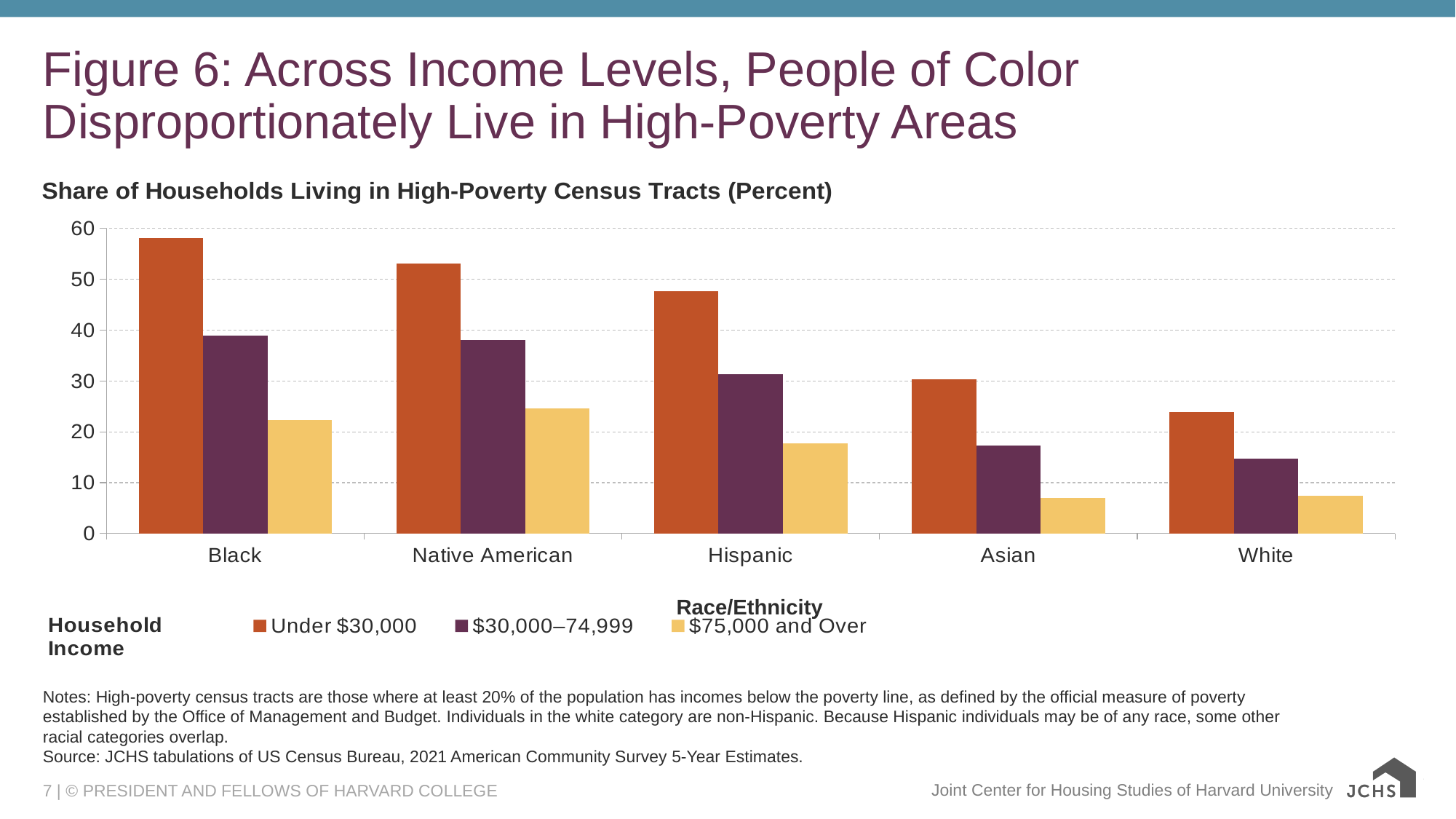
Is the $30,000–74,999 value for Hispanic greater or less than 30? greater Does the Under $30,000 series rise or fall moving from Black to White along the x axis? fall Which race/ethnicity has the lowest share for the Under $30,000 series? White Is the Under $30,000 value for Black greater or less than 50? greater What is the title of the chart above the plot area? Share of Households Living in High-Poverty Census Tracts (Percent) How many household income series does the legend list? 3 What kind of chart is shown on the slide? bar chart Which race/ethnicity has the highest share for the $75,000 and Over series? Native American Which race/ethnicity has the highest share for the Under $30,000 series? Black How many race/ethnicity categories are shown on the x axis? 5 Is the $75,000 and Over value for Asian greater or less than 10? less Which is larger: the Under $30,000 value for Hispanic or the Under $30,000 value for Asian? Hispanic